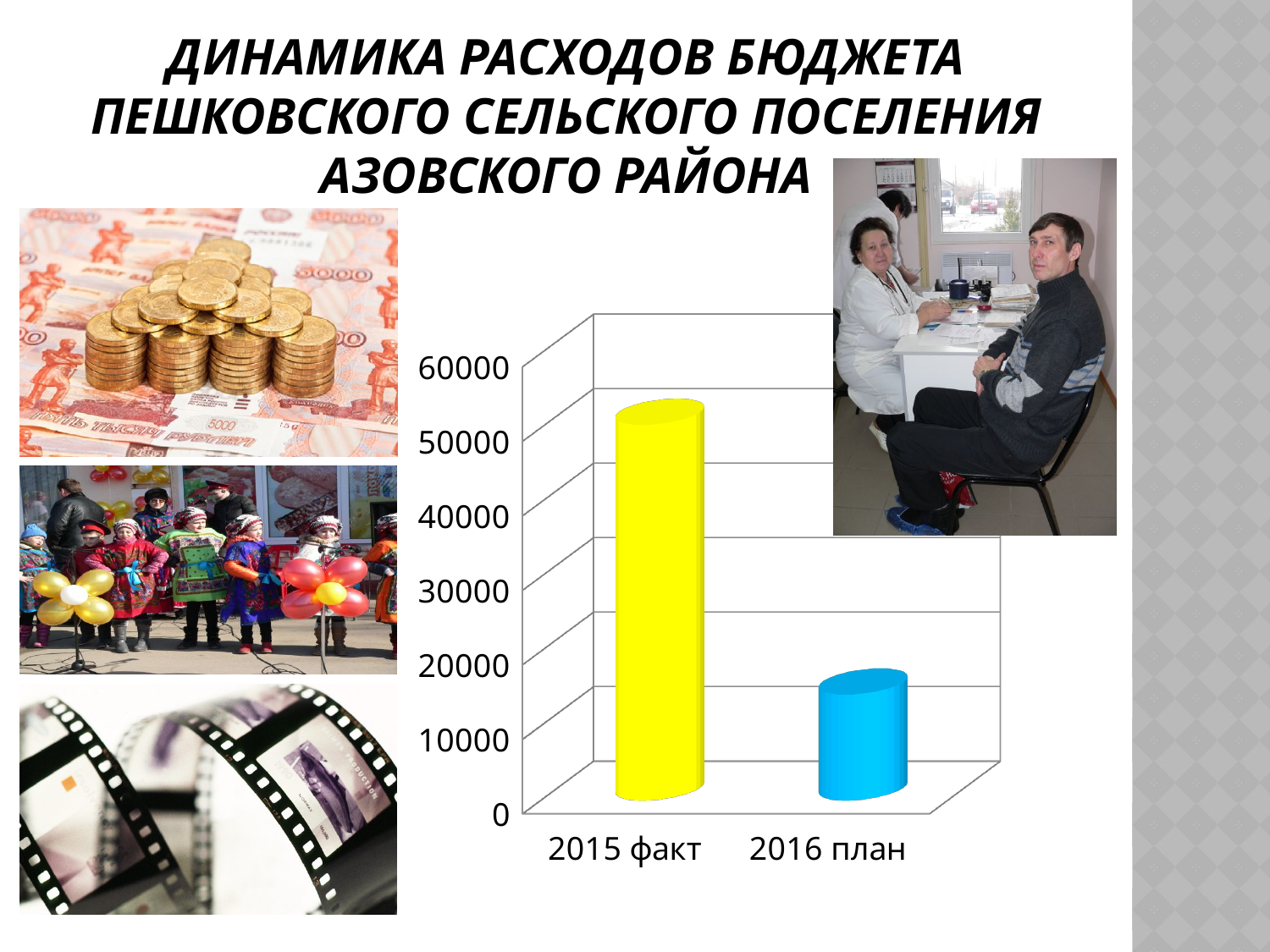
How many categories are plotted on the chart? 2 Is the value for 2016 план greater or less than 20000? less What colour is the bar for 2015 факт? yellow Is the value for 2016 план greater or less than 10000? greater What kind of chart is shown on the slide? bar chart Do the values rise or fall from 2015 факт to 2016 план? fall Is the value for 2015 факт greater or less than 60000? less Which category has the highest value on the chart? 2015 факт Which is larger, the value for 2015 факт or the value for 2016 план? 2015 факт What colour is the bar for 2016 план? blue Which category has the lowest value on the chart? 2016 план